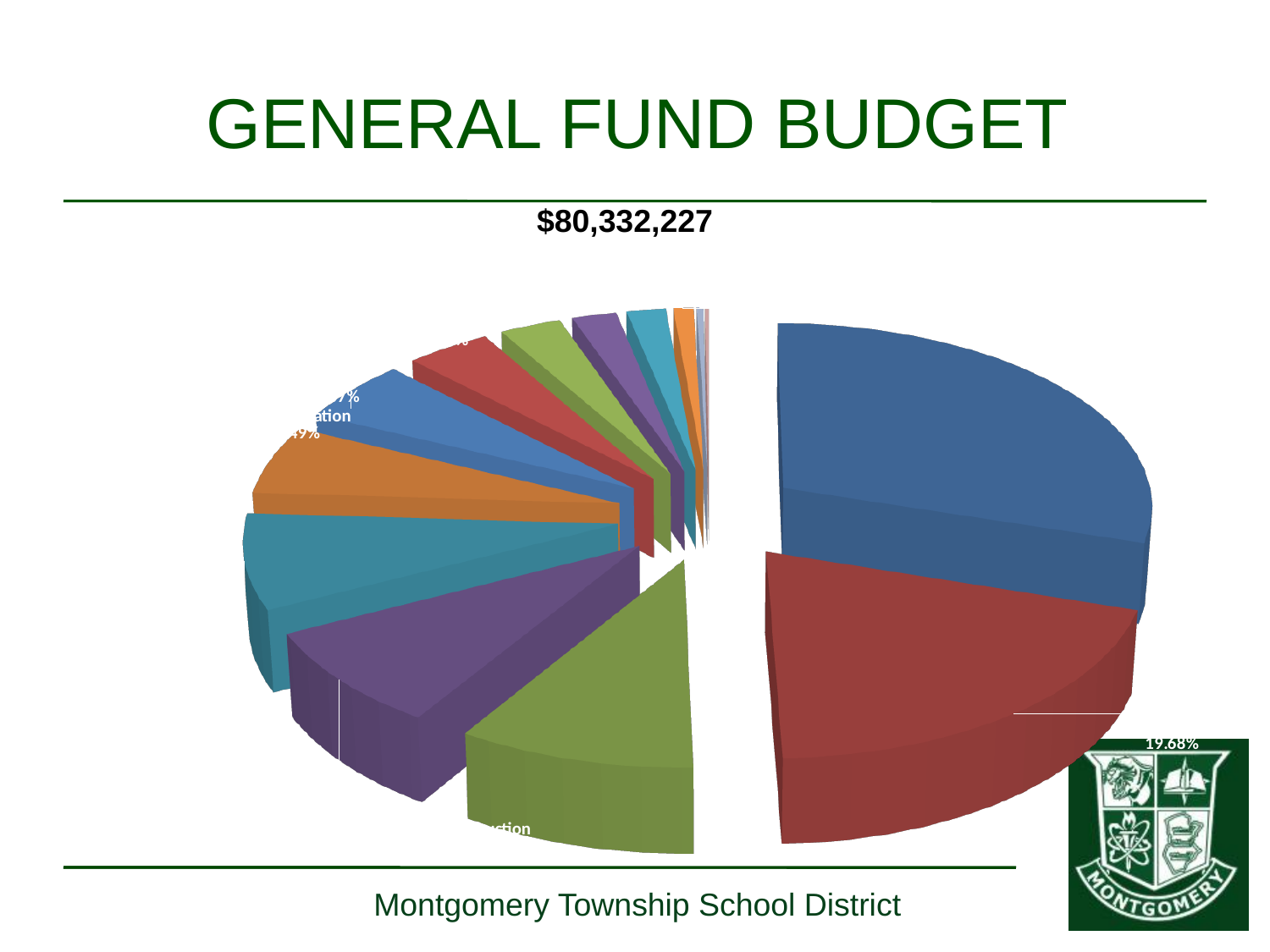
Which colour slice is the largest in the pie chart? blue What percentage label is shown for the red slice at the bottom right of the pie? 19.68% Which is larger, the blue slice or the green slice? blue What total dollar amount is shown above the pie chart? $80,332,227 What kind of chart is shown on the slide? pie chart What is the title of the slide containing the chart? GENERAL FUND BUDGET Which is larger, the red slice on the right or the purple slice on the left? red